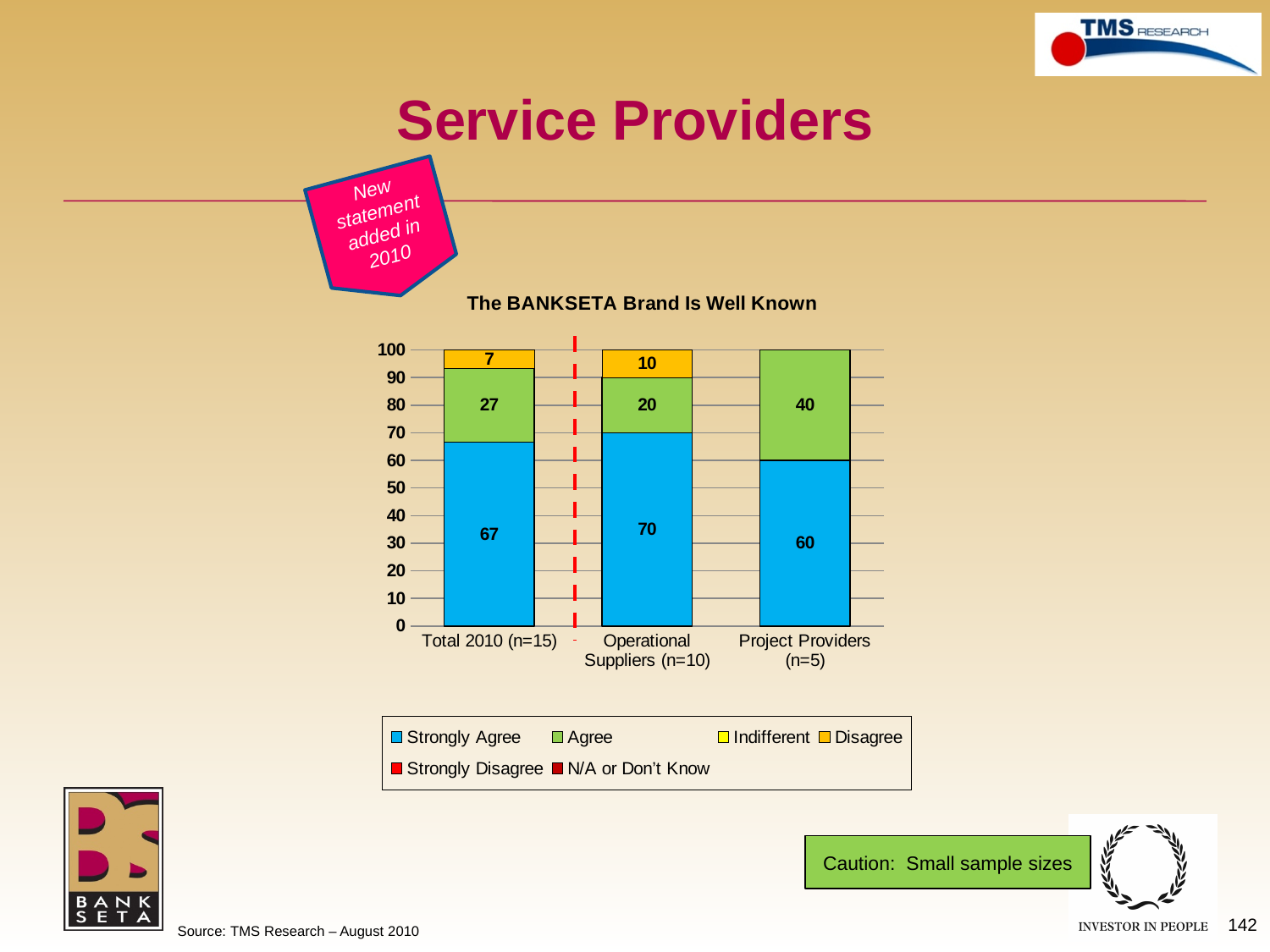
What is the Agree value for Total 2010 (n=15)? 27 Which category has the highest Strongly Agree value? Operational Suppliers (n=10) What is the Strongly Agree value for Operational Suppliers (n=10)? 70 What is the title of the chart? The BANKSETA Brand Is Well Known Which has a larger Agree value, Total 2010 (n=15) or Operational Suppliers (n=10)? Total 2010 (n=15) Which category has the lowest Strongly Agree value? Project Providers (n=5) How many series does the legend list? 6 What is the difference between the Agree values for Project Providers (n=5) and Operational Suppliers (n=10)? 20 What is the Strongly Agree value for Total 2010 (n=15)? 67 What is the Agree value for Project Providers (n=5)? 40 What kind of chart is shown on the slide? Stacked bar chart How many categories are shown on the x axis? 3